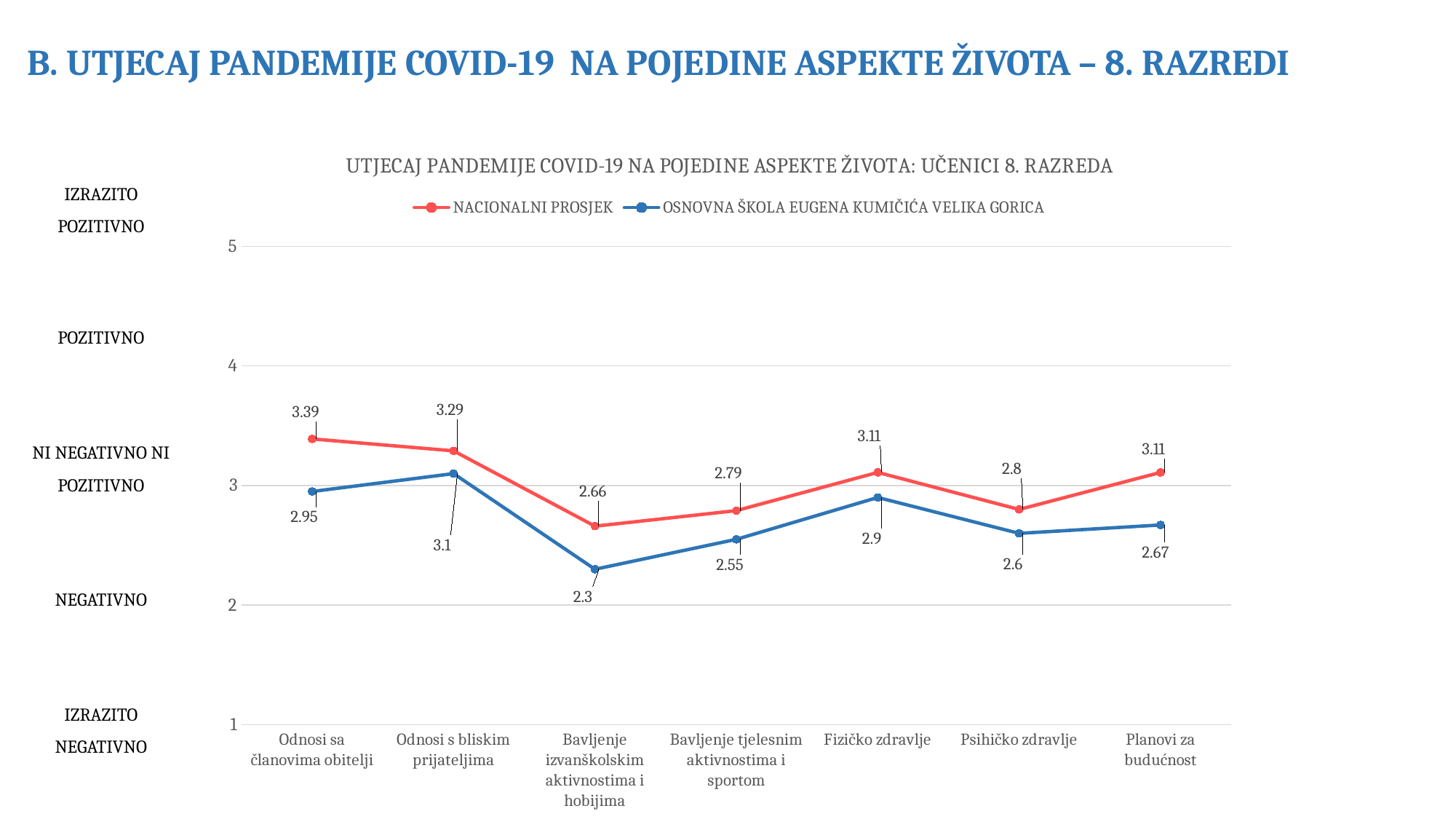
What is the difference between Nacionalni prosjek and Osnovna škola Eugena Kumičića Velika Gorica for Psihičko zdravlje? 0.2 What is the value for Osnovna škola Eugena Kumičića Velika Gorica for Bavljenje izvanškolskim aktivnostima i hobijima? 2.3 Which category has the lowest value for Osnovna škola Eugena Kumičića Velika Gorica? Bavljenje izvanškolskim aktivnostima i hobijima Which series has the larger value for Fizičko zdravlje? Nacionalni prosjek What type of chart is shown on the slide? line chart What is the value for Nacionalni prosjek for Odnosi sa članovima obitelji? 3.39 What is the title of the chart? UTJECAJ PANDEMIJE COVID-19 NA POJEDINE ASPEKTE ŽIVOTA: UČENICI 8. RAZREDA Which category has the highest value for Nacionalni prosjek? Odnosi sa članovima obitelji What is the value for Osnovna škola Eugena Kumičića Velika Gorica for Planovi za budućnost? 2.67 Is the value for Nacionalni prosjek for Bavljenje tjelesnim aktivnostima i sportom greater or less than 3? less How many series does the legend list? 2 How many categories are shown on the x axis? 7